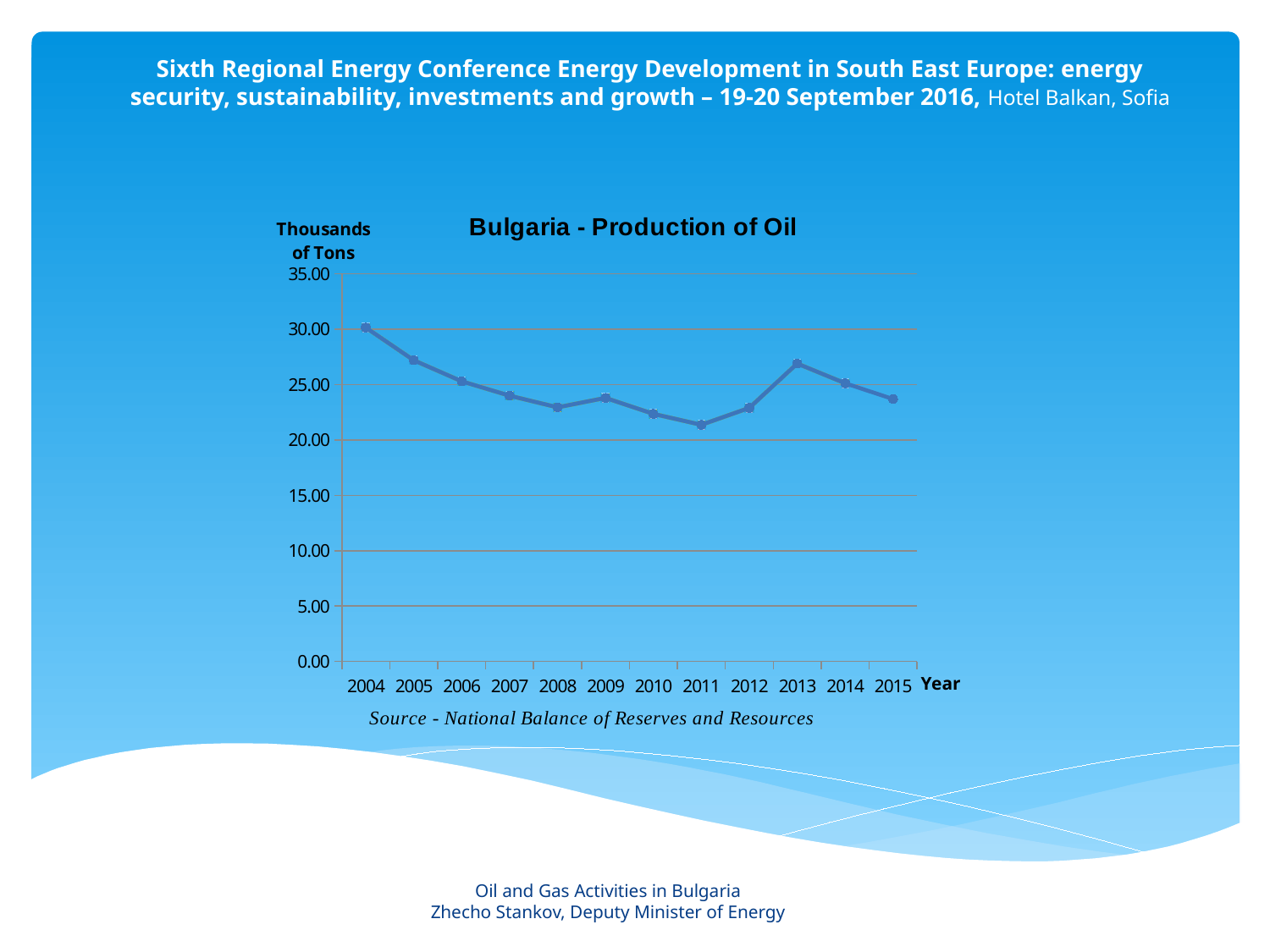
What kind of chart is shown on the slide? line chart Which year has the highest oil production on the chart? 2004 What unit is shown on the vertical axis label of the chart? Thousands of Tons Which year has the larger value, 2004 or 2015? 2004 Which year has the larger value, 2013 or 2011? 2013 Do the values rise or fall from 2004 to 2008? fall Is the value for 2004 greater or less than 25.00? greater Is the value for 2008 greater or less than 25.00? less Which year has the lowest oil production on the chart? 2011 Is the value for 2011 greater or less than 25.00? less What is the title of the chart? Bulgaria - Production of Oil How many years are plotted on the chart? 12